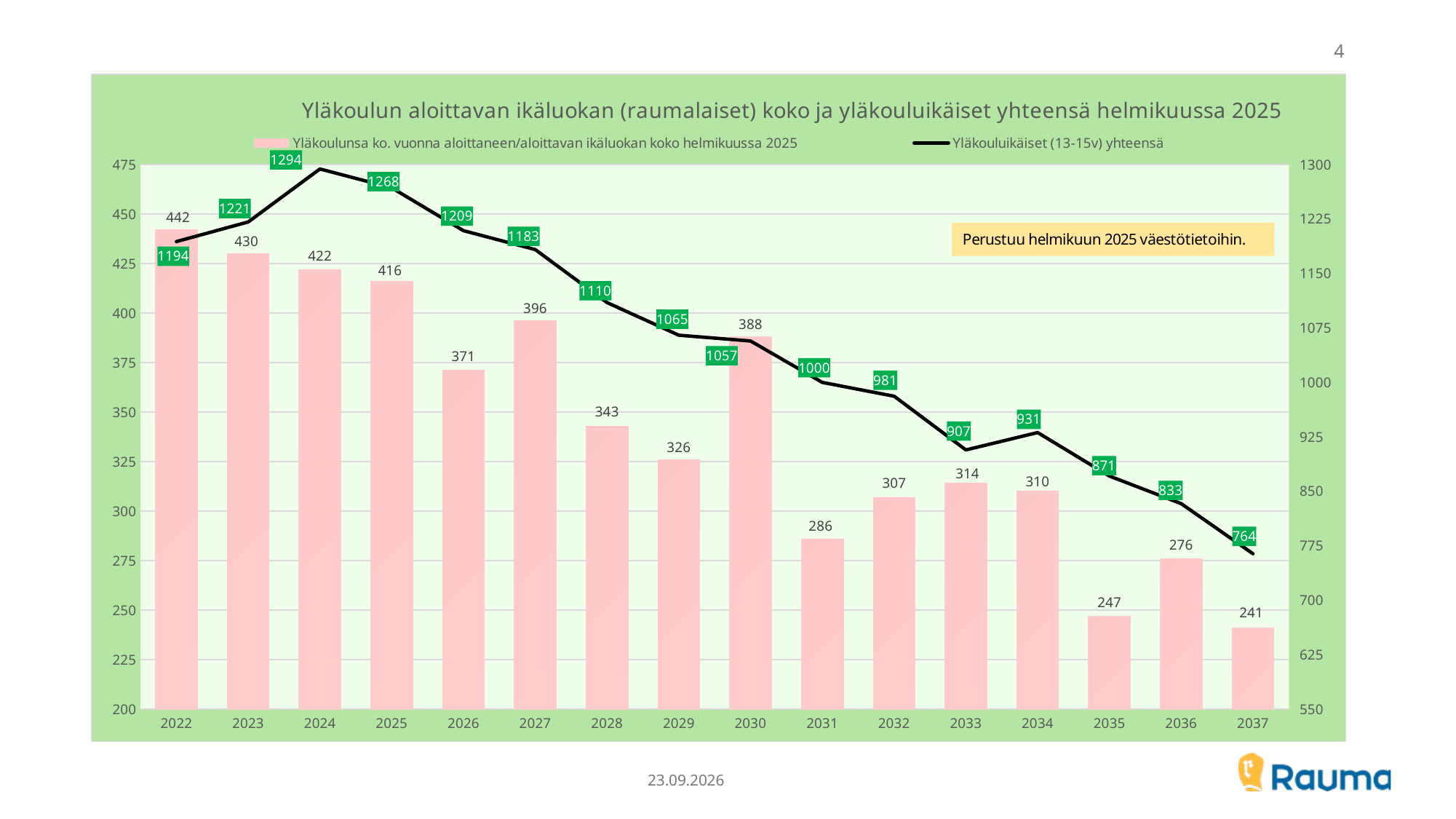
How many series does the legend list? 2 Which is larger, the bar value for 2030 or the bar value for 2029? 2030 Does the line series generally rise or fall from 2024 to 2037? Fall What is the value of the bar for 2022? 442 Which year has the highest value in the line series? 2024 What kinds of chart are combined on this slide? Bar chart and line chart What is the value of the line series for 2033? 907 How many years are shown on the x axis? 16 Which year has the lowest bar value? 2037 What is the difference between the bar values for 2022 and 2037? 201 What is the value of the bar for 2037? 241 What is the value of the line series (Yläkouluikäiset (13-15v) yhteensä) for 2024? 1294